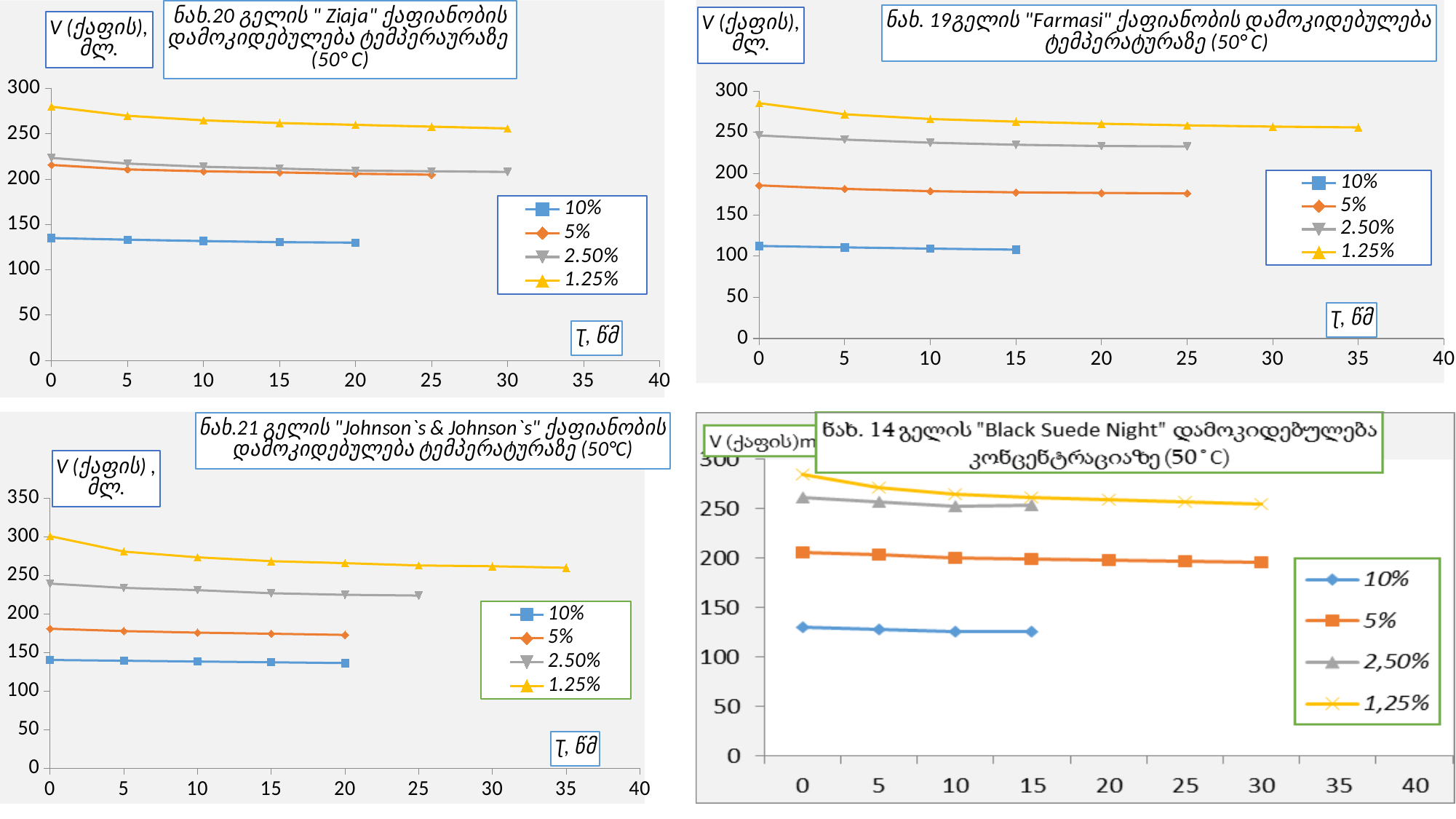
In the top-right chart (Farmasi), do the values of the 1.25% series rise or fall as time increases? fall In the bottom-right chart (Black Suede Night), is the value of the 10% series at time 0 greater or less than 150? less In the bottom-left chart (Johnson`s & Johnson`s), how many data points does the 1.25% series have? 8 In the top-left chart (Ziaja), which series has the highest values? 1.25% In the top-right chart (Farmasi), how many data points does the 10% series have? 4 In the top-left chart (Ziaja), is the value of the 10% series at time 0 greater or less than 150? less In the top-right chart (Farmasi), is the value of the 5% series at time 0 greater or less than 200? less What kind of chart is the top-left chart (Ziaja)? line chart How many series does the legend of the top-right chart (Farmasi) list? 4 In the bottom-left chart (Johnson`s & Johnson`s), which series has the lowest values? 10% In the bottom-right chart (Black Suede Night), which is larger at time 0: the 2,50% series or the 5% series? 2,50%